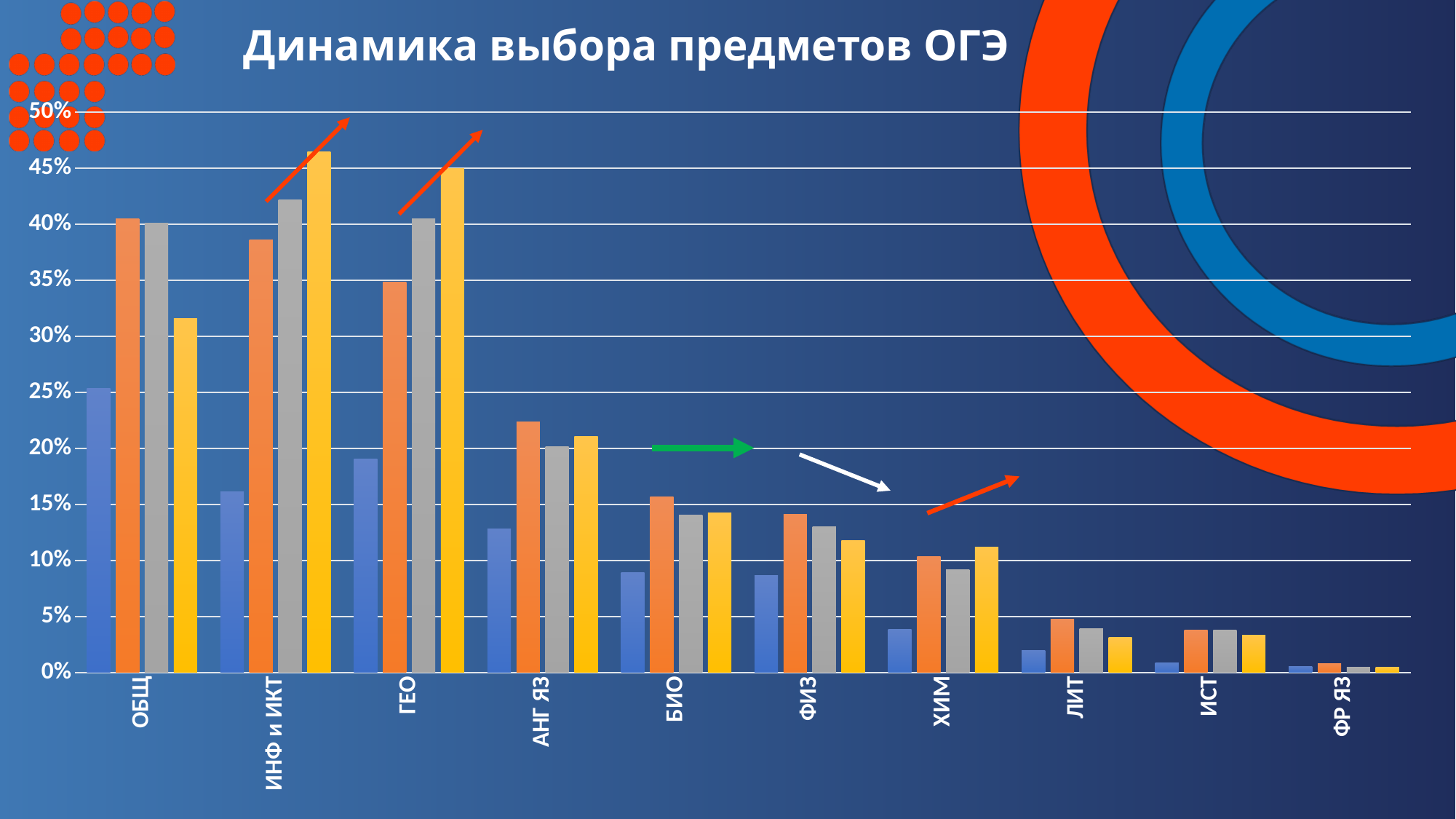
How many subject categories are shown on the x axis? 10 Is the blue bar for ФР ЯЗ greater or less than 5%? less For ОБЩ, which is larger: the orange bar or the yellow bar? the orange bar Is the blue bar for ОБЩ greater or less than 20%? greater What is the title of the chart? Динамика выбора предметов ОГЭ Do the values generally rise or fall moving from left to right along the x axis? fall Which subject has the tallest bar on the chart? ИНФ и ИКТ How many bars are plotted for each subject category? 4 What kind of chart is shown on the slide? bar chart Which subject has the lowest values on the chart? ФР ЯЗ Is the orange bar for ГЕО greater or less than 30%? greater